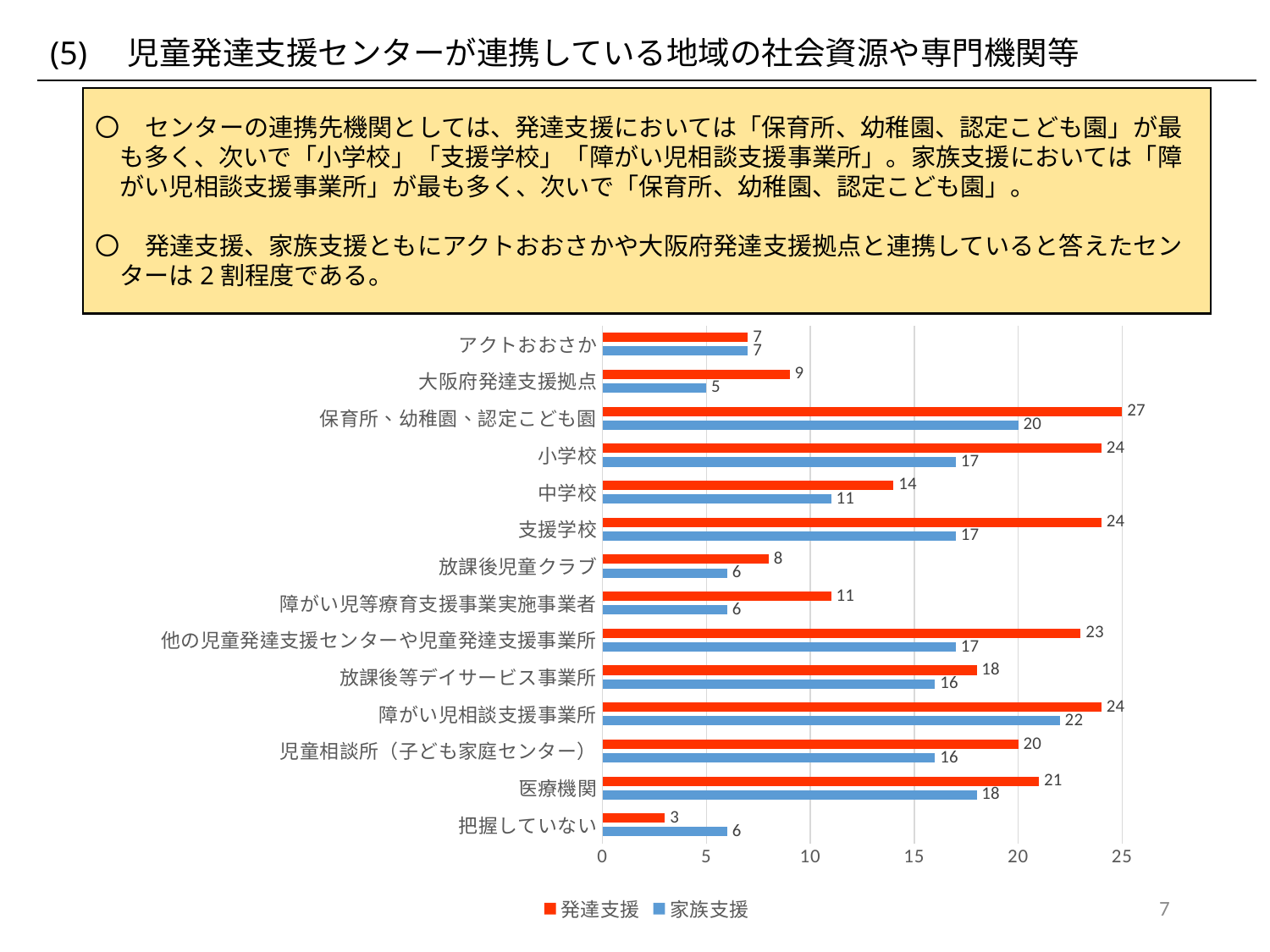
What is the difference between the 発達支援 and 家族支援 values for 小学校? 7 What is the 家族支援 value for 大阪府発達支援拠点? 5 Which category has the highest 家族支援 value? 障がい児相談支援事業所 How many categories are shown on the chart? 14 For 把握していない, which is larger, the 発達支援 value or the 家族支援 value? 家族支援 What is the 発達支援 value for 保育所、幼稚園、認定こども園? 27 Which series is shown in red in the legend? 発達支援 What type of chart is shown on the slide? bar chart Which category has the highest 発達支援 value? 保育所、幼稚園、認定こども園 What is the 家族支援 value for 障がい児相談支援事業所? 22 Which category has the lowest 発達支援 value? 把握していない How many series does the legend list? 2